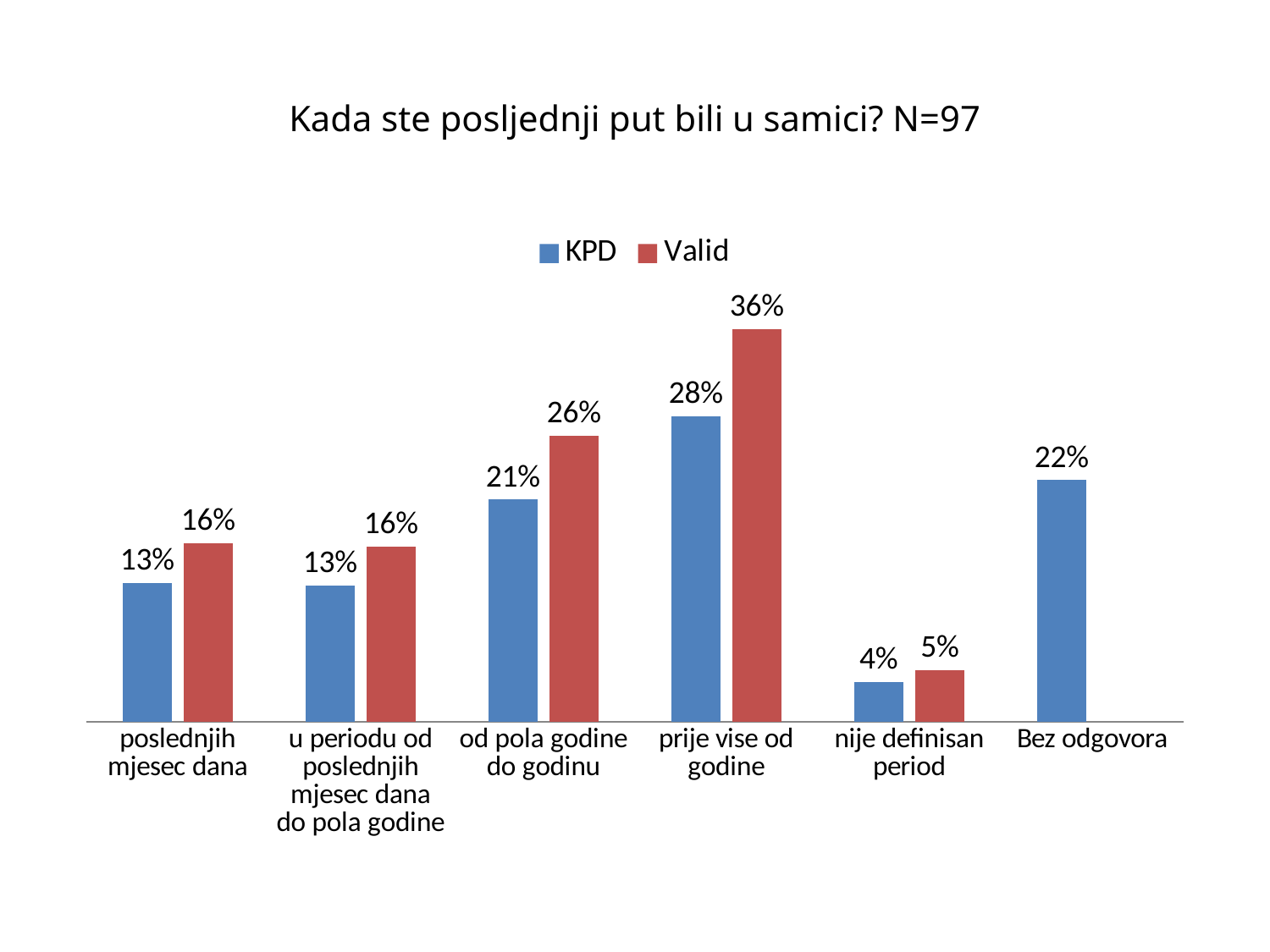
What is the title of the chart? Kada ste posljednji put bili u samici? N=97 What is the difference between the Valid and KPD values for 'prije vise od godine'? 8% How many series does the legend list? 2 Which is larger for 'od pola godine do godinu': the KPD value or the Valid value? Valid What is the KPD value for 'Bez odgovora'? 22% Which category has the highest Valid value? prije vise od godine What is the Valid value for 'nije definisan period'? 5% What is the KPD value for 'prije vise od godine'? 28% What kind of chart is shown on the slide? bar chart What is the Valid value for 'od pola godine do godinu'? 26% How many categories are shown on the x axis? 6 Which category has the lowest KPD value? nije definisan period